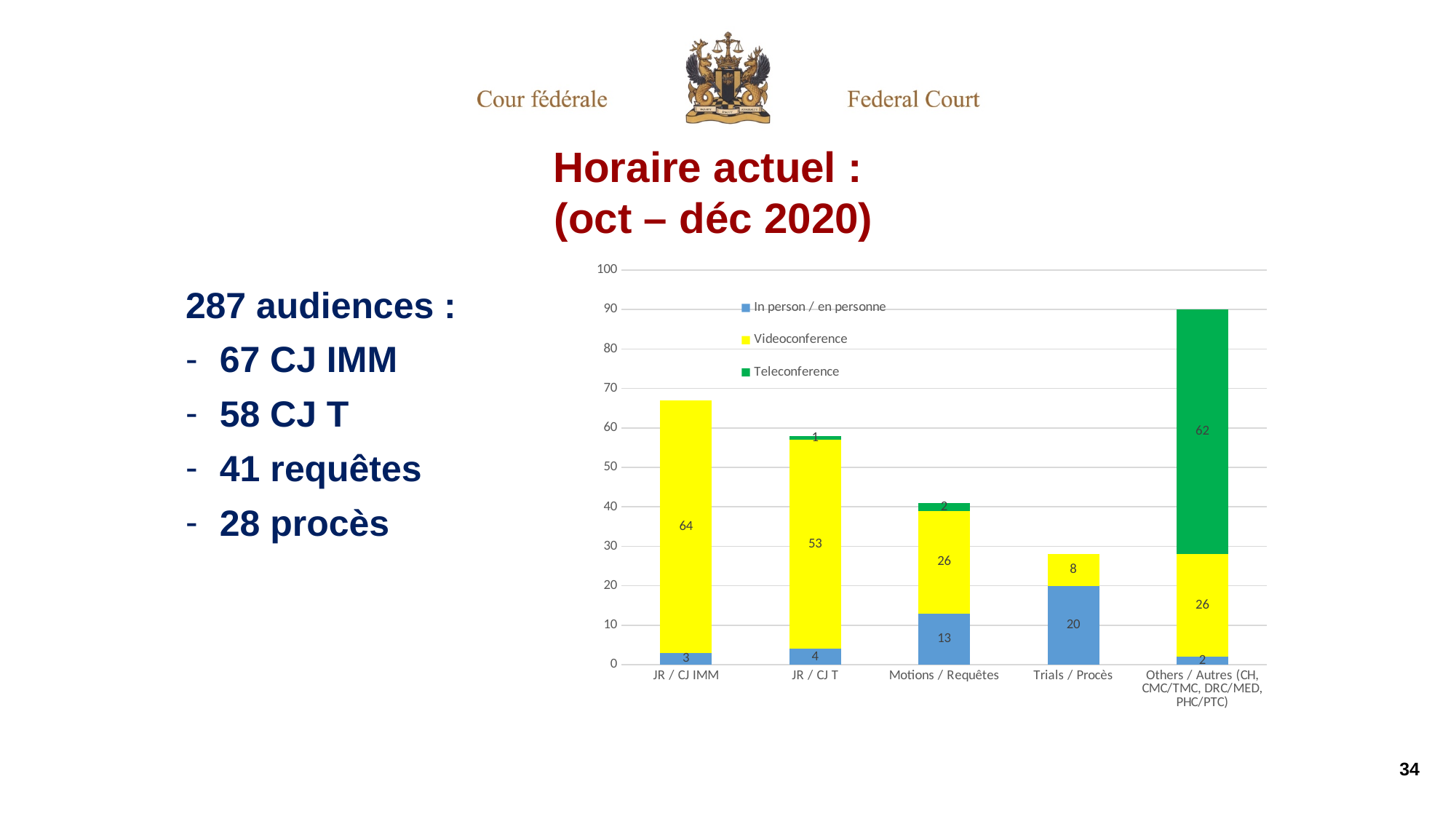
How many categories are shown on the x axis of the chart? 5 What is the total of the stacked bar for Motions / Requêtes? 41 How many series does the chart legend list? 3 Which category has the highest In person / en personne value? Trials / Procès What is the difference between the Videoconference values for JR / CJ IMM and JR / CJ T? 11 What is the Videoconference value for JR / CJ IMM? 64 What type of chart is shown on the slide? stacked bar chart What is the Teleconference value for JR / CJ T? 1 What is the Teleconference value for Others / Autres (CH, CMC/TMC, DRC/MED, PHC/PTC)? 62 What is the In person / en personne value for Trials / Procès? 20 Which is larger: the In person / en personne value for Motions / Requêtes or for JR / CJ T? Motions / Requêtes Which category has the lowest Videoconference value? Trials / Procès